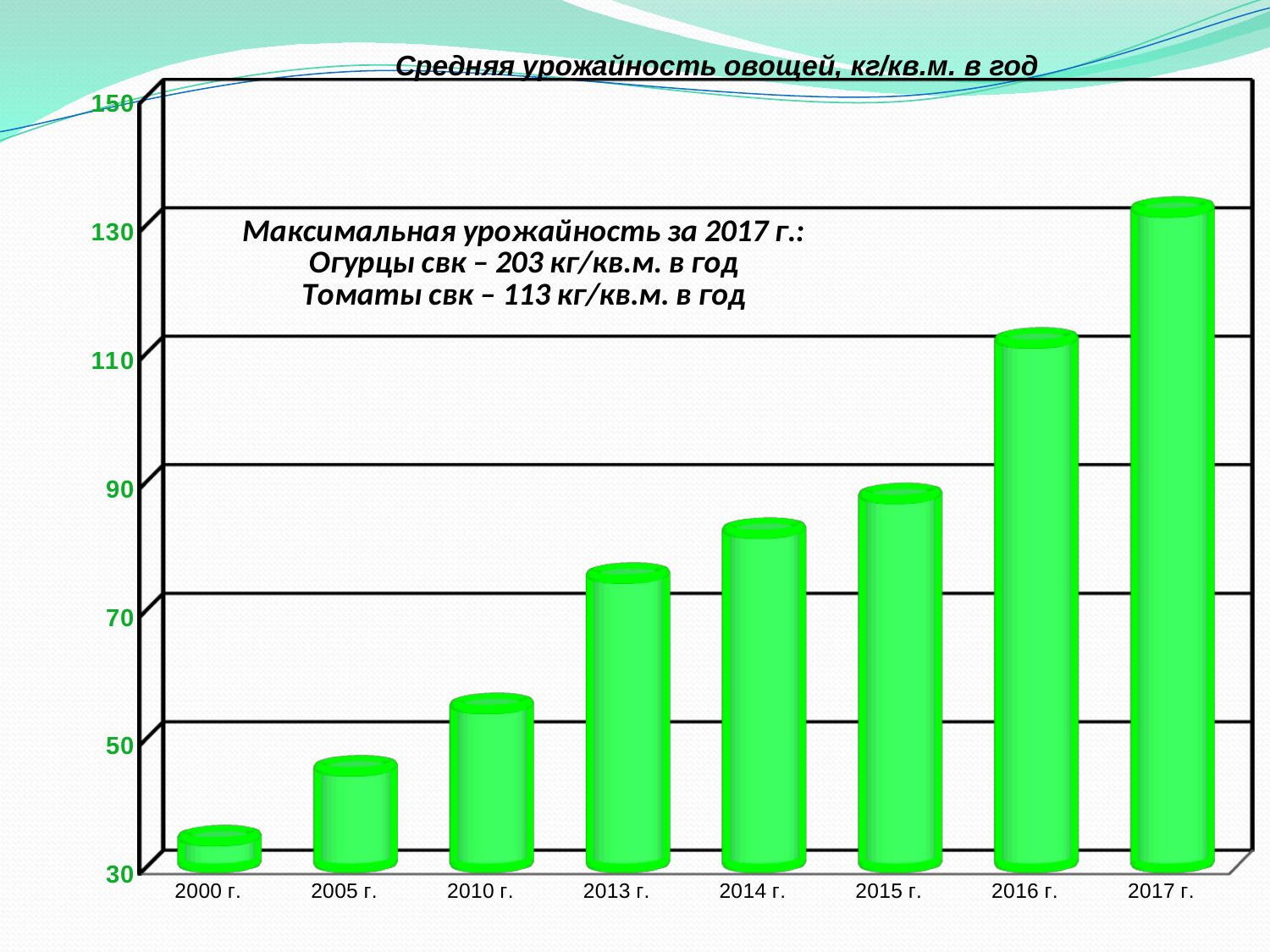
Which is larger, the value for 2016 г. or the value for 2014 г.? 2016 г. Which year has the highest average vegetable yield? 2017 г. Is the value for 2005 г. greater or less than 50? less What kind of chart is shown on the slide? bar chart How many years (categories) are plotted on the chart? 8 Is the value for 2014 г. greater or less than 90? less According to the text on the chart, what was the maximum yield of cucumbers (Огурцы свк) in 2017? 203 кг/кв.м. в год Is the value for 2017 г. greater or less than 110? greater Do the values rise or fall from 2000 г. to 2017 г.? rise What is the title of the chart? Средняя урожайность овощей, кг/кв.м. в год Which year has the lowest average vegetable yield? 2000 г.